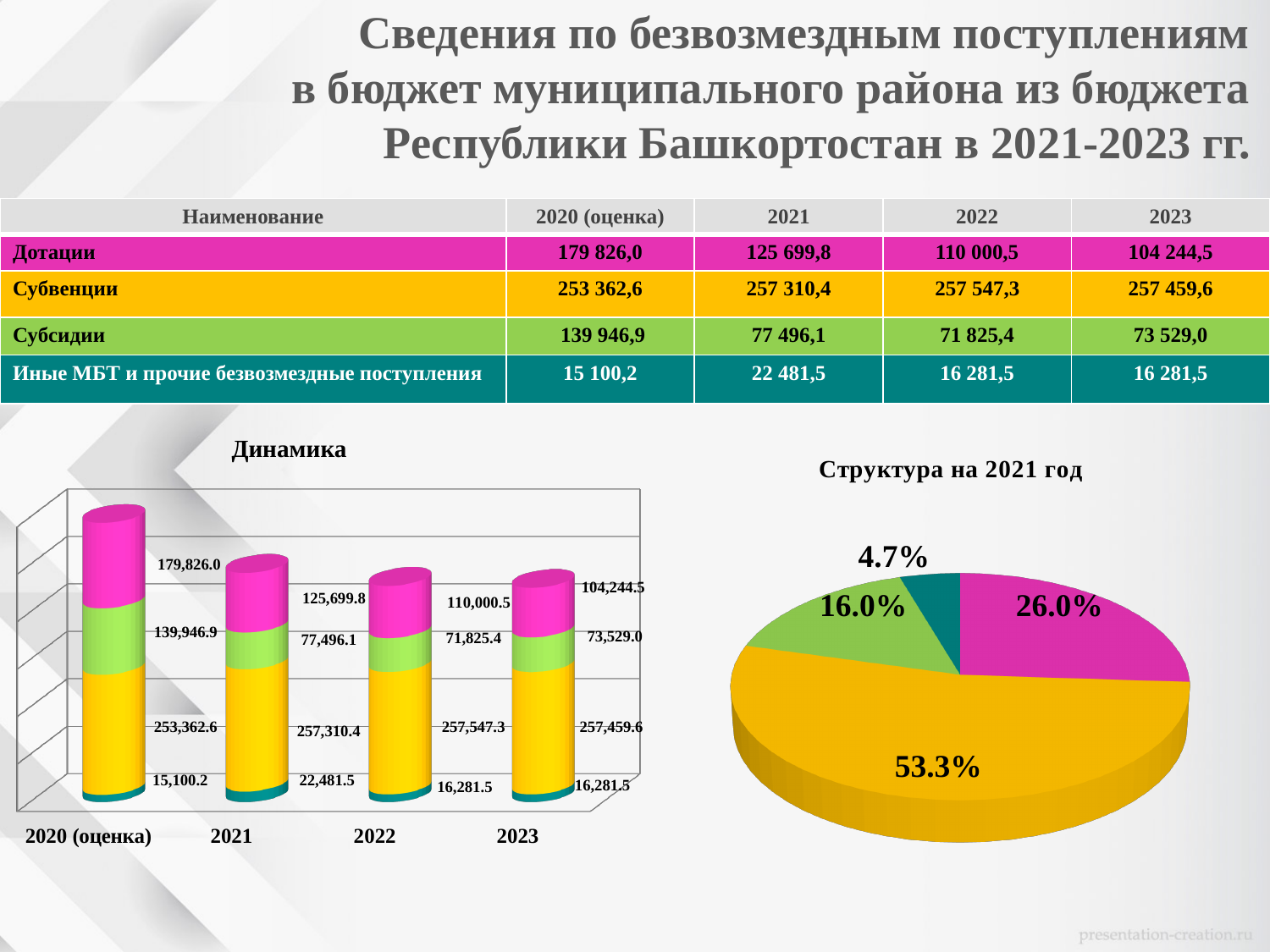
In the "Динамика" chart, what is the difference between the pink segment values for 2020 (оценка) and 2023? 75,581.5 In the "Структура на 2021 год" chart, which slice is the smallest? 4.7% In the "Динамика" chart, what is the value of the pink (top) segment for 2020 (оценка)? 179,826.0 In the "Динамика" chart, what is the value of the yellow segment for 2022? 257,547.3 In the "Динамика" chart, what is the total of the stacked bar for 2021? 482,987.8 What kind of chart is the "Динамика" chart? bar chart In the "Динамика" chart, is the green segment larger for 2020 (оценка) or for 2021? 2020 (оценка) In the "Динамика" chart, does the pink (top) segment rise or fall from 2020 (оценка) to 2023? fall In the "Динамика" chart, what is the value of the teal (bottom) segment for 2021? 22,481.5 In the "Структура на 2021 год" chart, which slice is the largest? 53.3% In the "Динамика" chart, how many categories are shown on the x axis? 4 What kind of chart is the "Структура на 2021 год" chart? pie chart